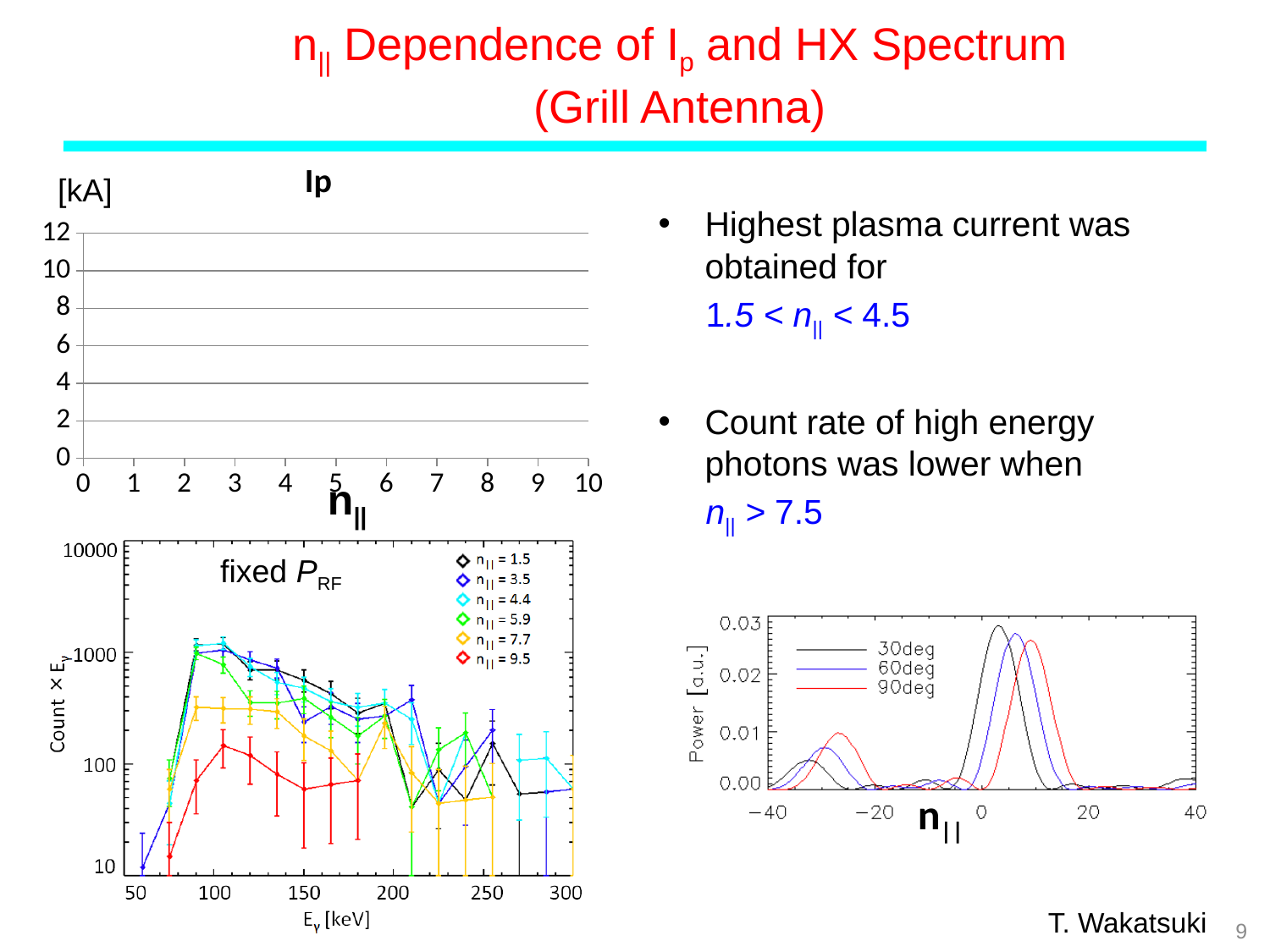
On the bottom-left HX spectrum chart, what n|| values are listed in the legend? 1.5, 3.5, 4.4, 5.9, 7.7, 9.5 On the bottom-left HX spectrum chart, which series has the lowest counts across the energy range? n|| = 9.5 On the bottom-right Power chart, is the secondary peak of the 90deg curve near n|| = -27 greater or less than 0.02? less On the bottom-right Power chart, is the main peak of the 30deg curve greater or less than 0.02? greater On the bottom-left HX spectrum chart, what kind of chart is it? line chart On the bottom-right Power chart, how many series does the legend list? 3 On the bottom-left HX spectrum chart, how many series does the legend list? 6 On the bottom-right Power chart, which curve has its main peak at the largest n|| value? 90deg On the bottom-left HX spectrum chart, is the value for n|| = 9.5 at 150 keV greater or less than 100? less On the bottom-left HX spectrum chart, do the counts generally rise or fall as energy increases from 100 keV to 300 keV? fall On the bottom-right Power chart, what are the legend entries? 30deg, 60deg, 90deg